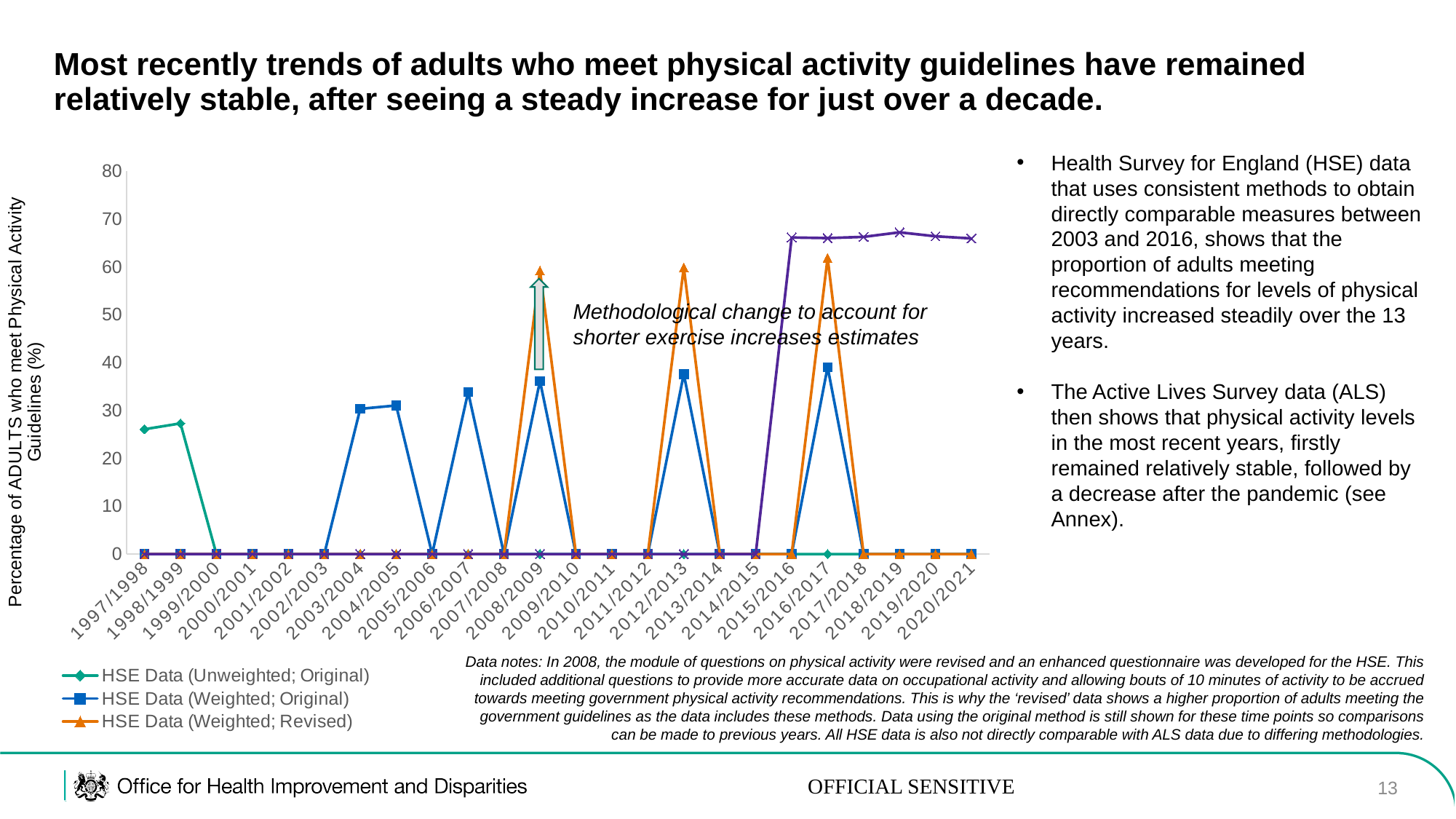
What is the label on the y axis of the chart? Percentage of ADULTS who meet Physical Activity Guidelines (%) In 2012/2013, which series has the larger value: HSE Data (Weighted; Revised) or HSE Data (Weighted; Original)? HSE Data (Weighted; Revised) Is the value for HSE Data (Weighted; Revised) in 2012/2013 greater or less than 50? greater How many series does the chart legend list? 3 What kind of chart is shown on the slide? Line chart Is the value for HSE Data (Weighted; Revised) in 2008/2009 greater or less than 50? greater How many year categories are shown on the x axis? 24 Is the value for HSE Data (Weighted; Original) in 2006/2007 greater or less than 30? greater Which is larger for HSE Data (Weighted; Original): the value in 2006/2007 or the value in 2003/2004? 2006/2007 What does the italic annotation inside the chart say? Methodological change to account for shorter exercise increases estimates